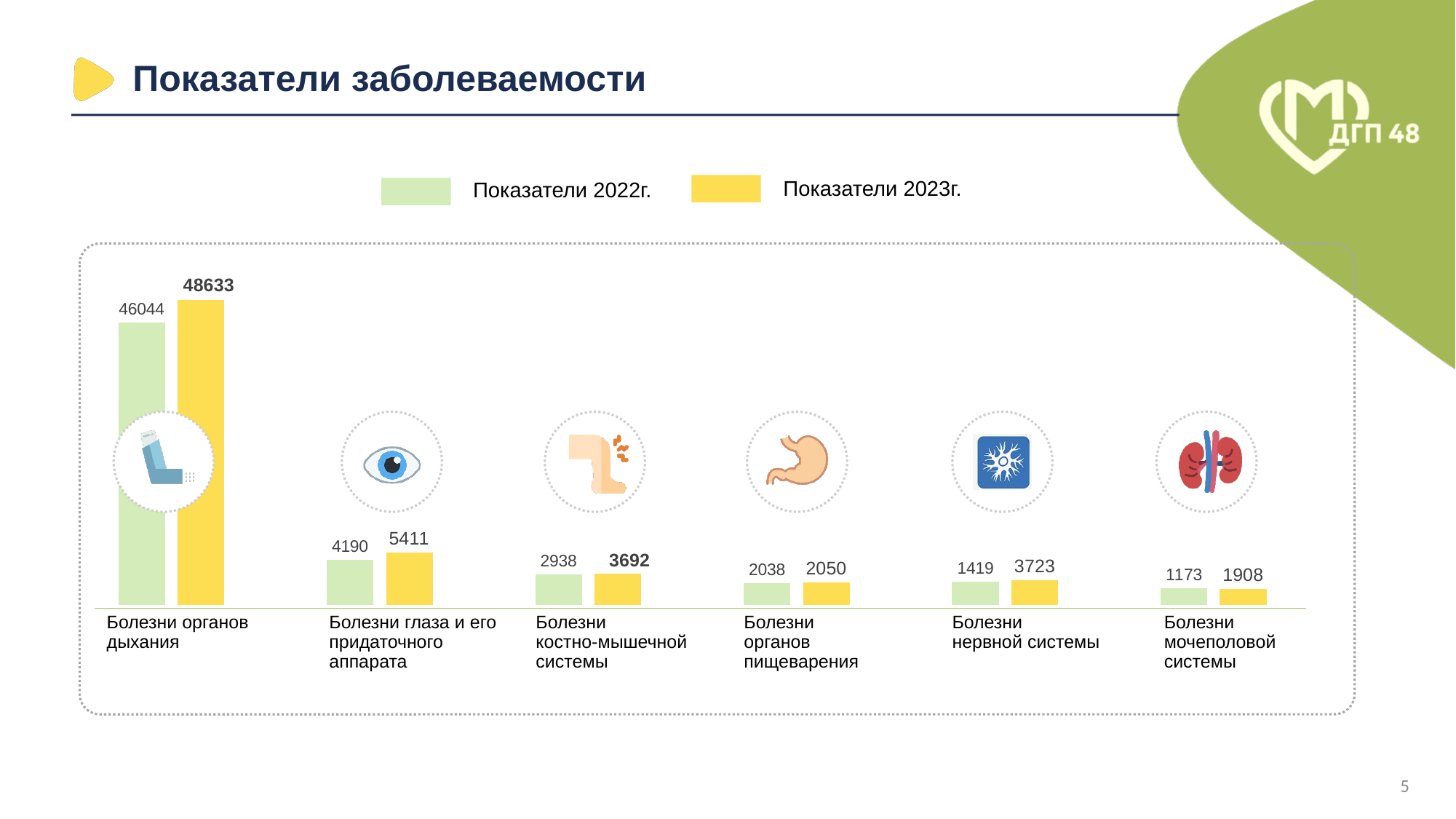
Which category has the highest 2023 value? Болезни органов дыхания Which category has the lowest 2022 value? Болезни мочеполовой системы What is the difference between the 2023 and 2022 values for Болезни нервной системы? 2304 What kind of chart is shown on the slide? Bar chart How many series does the legend list? 2 Which is larger: the 2023 value for Болезни глаза и его придаточного аппарата or the 2023 value for Болезни нервной системы? Болезни глаза и его придаточного аппарата What is the 2023 value (Показатели 2023г.) for Болезни органов дыхания? 48633 What is the difference between the 2023 and 2022 values for Болезни органов дыхания? 2589 Which colour represents Показатели 2023г. in the legend? Yellow What is the 2023 value for Болезни мочеполовой системы? 1908 How many disease categories are shown in the chart? 6 What is the 2022 value (Показатели 2022г.) for Болезни нервной системы? 1419